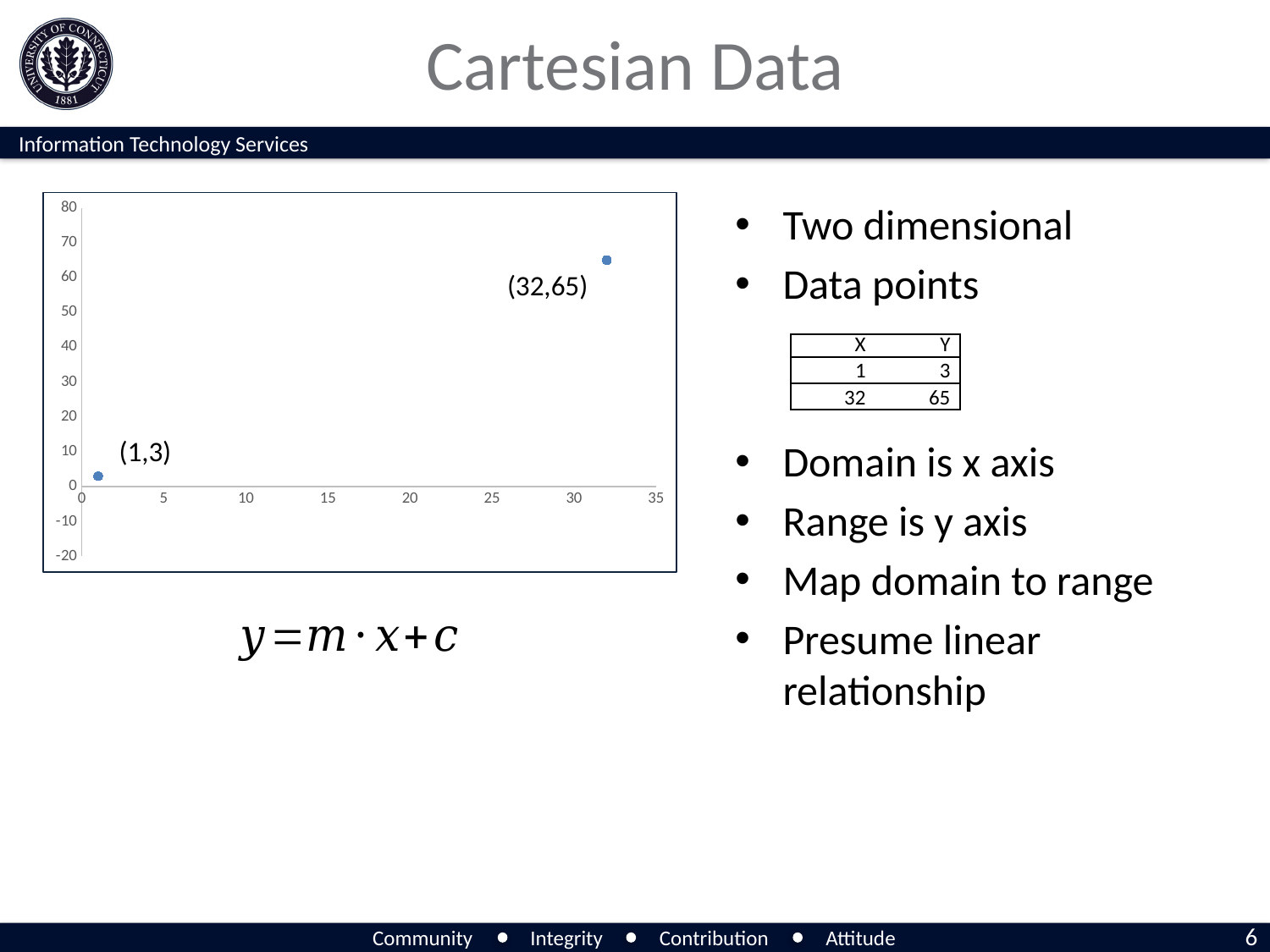
Do the y values rise or fall as x increases along the chart? rise Which data point has the higher y value, (1,3) or (32,65)? (32,65) What kind of chart is shown on the slide? scatter chart What is the difference in y value between the point at x = 32 and the point at x = 1? 62 How many data points are plotted on the chart? 2 What are the coordinates of the lower-left data point on the chart? (1,3) What are the coordinates of the upper-right data point on the chart? (32,65) What is the highest value shown on the chart's y axis? 80 What is the y value of the data point at x = 32? 65 Is the y value of the point at x = 32 greater or less than 60? greater What is the y value of the data point at x = 1? 3 Which data point has the lowest y value? (1,3)